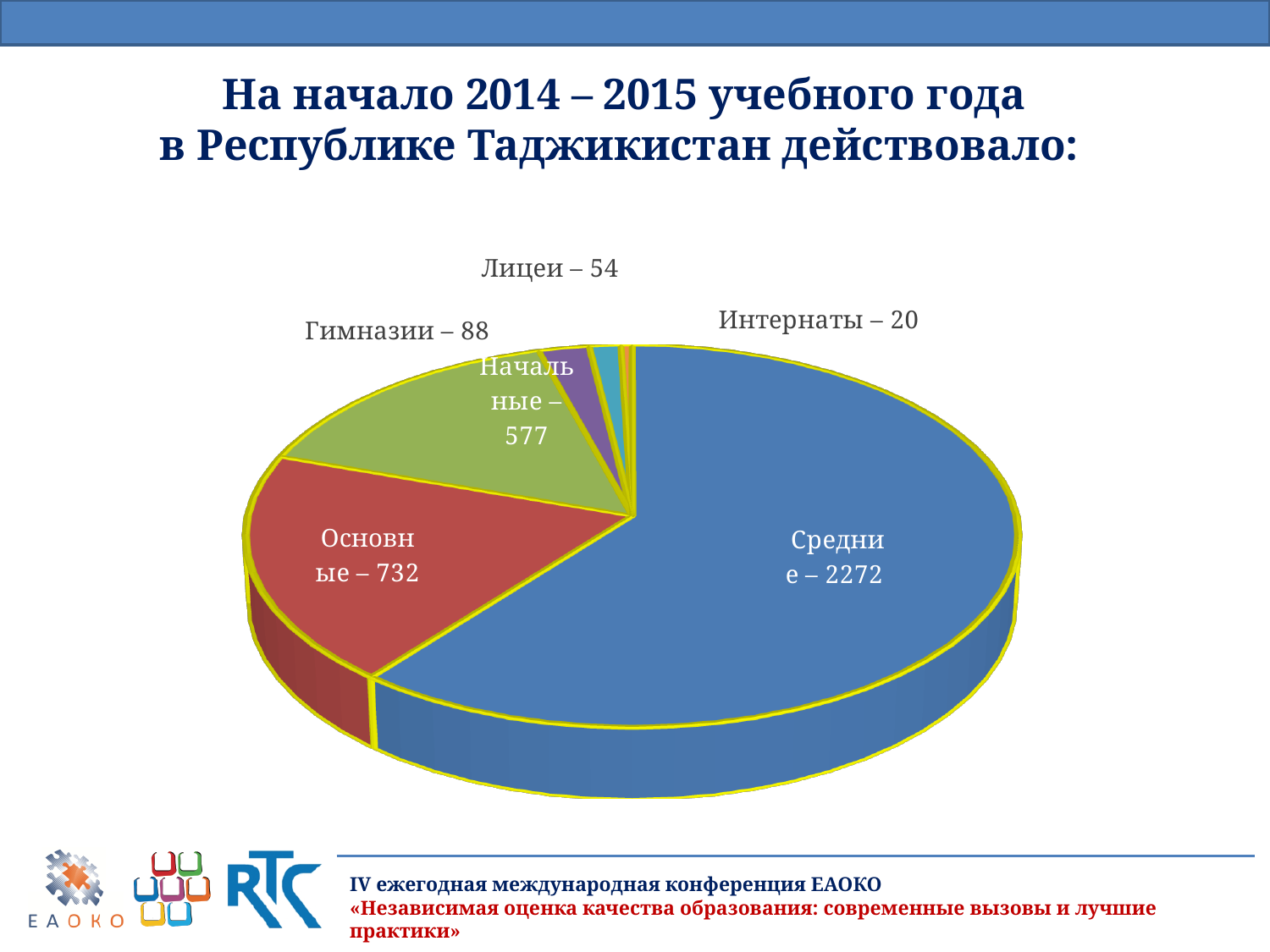
What is the total of all the values shown in the pie chart? 3743 What is the value for Гимназии? 88 Which category has the smallest slice of the pie? Интернаты How many slices does the pie chart have? 6 What is the difference between the values for Основные and Начальные? 155 Which category has the largest slice of the pie? Средние What type of chart is shown on the slide? pie chart What is the value for Начальные? 577 Which is larger, the value for Гимназии or the value for Лицеи? Гимназии What is the value for Основные? 732 What is the value for Интернаты? 20 What is the value for Средние? 2272